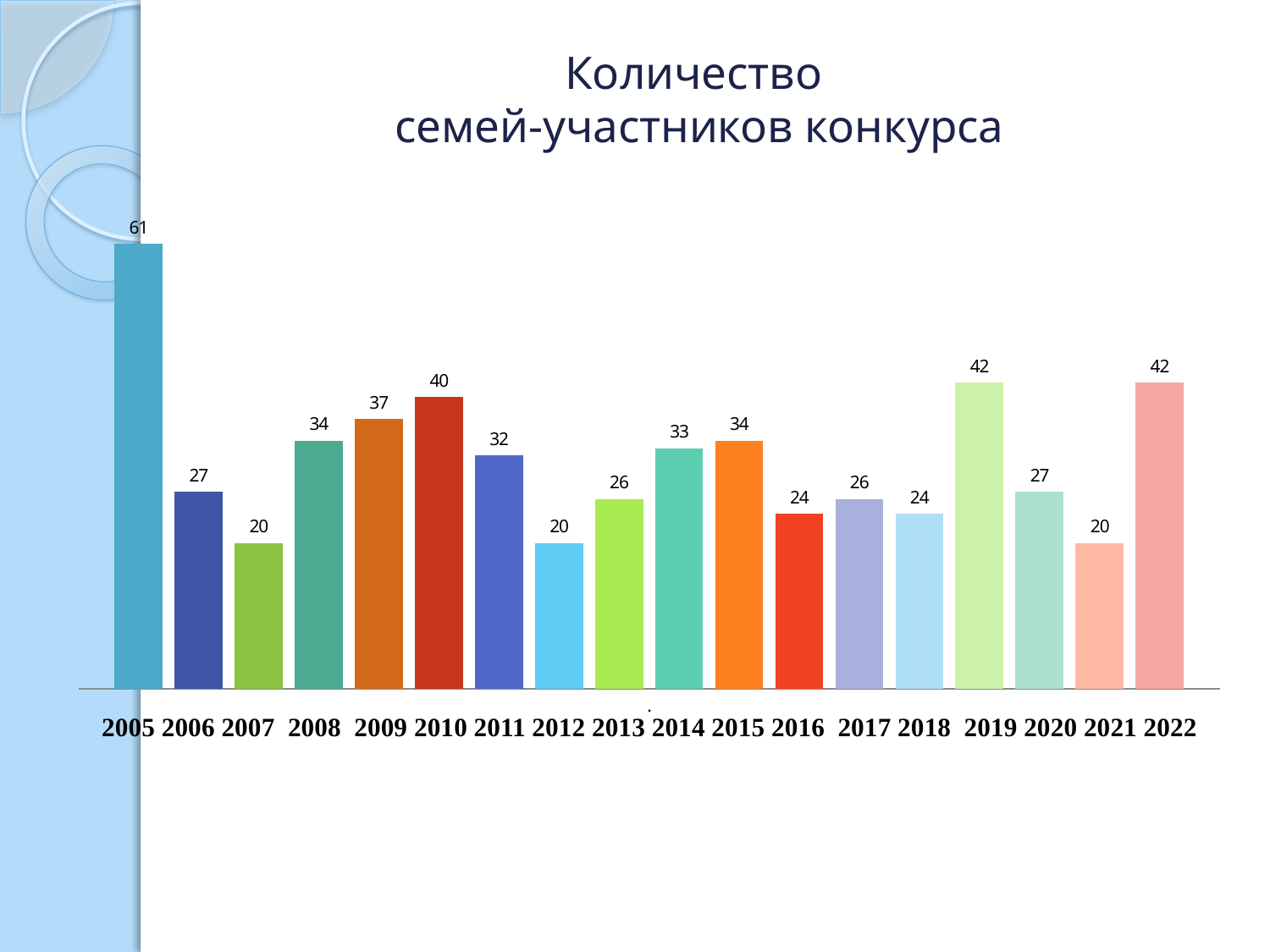
Which is larger, the value for 2013 or the value for 2020? 2020 Which is larger, the value for 2011 or the value for 2016? 2011 Which year has the highest value? 2005 What kind of chart is shown on the slide? bar chart Do the values rise or fall from 2016 to 2019? rise What is the difference between the values for 2005 and 2022? 19 How many years are shown on the x axis? 18 What is the value for 2018? 24 What is the value for 2005? 61 What is the title of the chart? Количество семей-участников конкурса What is the difference between the values for 2009 and 2012? 17 What is the value for 2010? 40